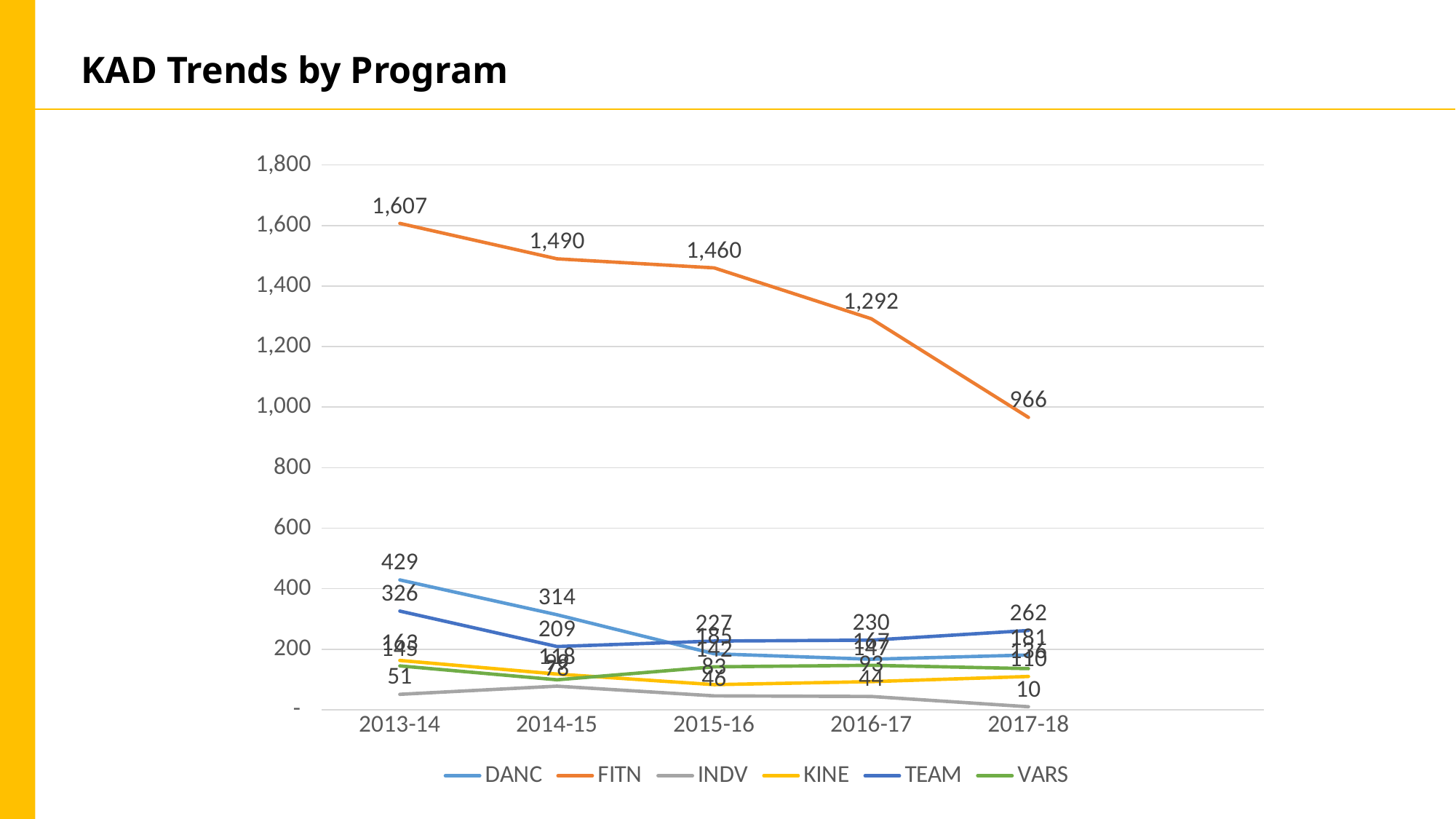
How many series does the legend list? 6 What is the value for TEAM in 2017-18? 262 What is the value for FITN in 2013-14? 1,607 Which is larger in 2013-14, DANC or TEAM? DANC Which program has the highest value in 2013-14? FITN What kind of chart is shown on the slide? line chart What is the difference between the FITN values in 2013-14 and 2017-18? 641 In which year is the FITN value lowest? 2017-18 What is the value for DANC in 2013-14? 429 What is the value for FITN in 2017-18? 966 Does the FITN value rise or fall from 2013-14 to 2017-18? fall What is the value for INDV in 2017-18? 10